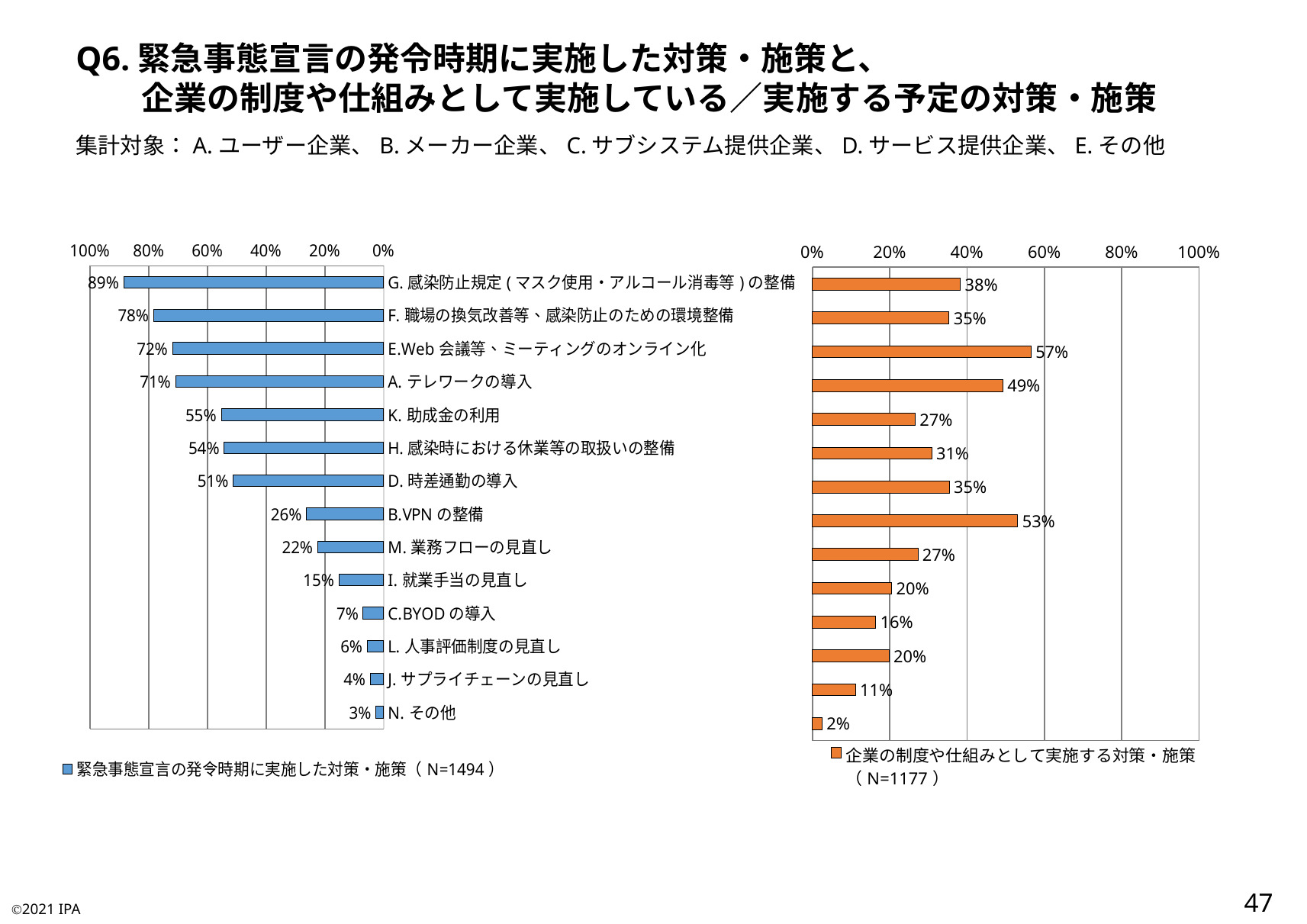
左側のグラフ（緊急事態宣言の発令時期に実施した対策・施策）で、最も値が高い項目はどれですか？ G. 感染防止規定 ( マスク使用・アルコール消毒等 ) の整備 右側のグラフ（企業の制度や仕組みとして実施する対策・施策）で、最も値が高い項目はどれですか？ E.Web 会議等、ミーティングのオンライン化 右側のグラフ（企業の制度や仕組みとして実施する対策・施策）で、「B.VPN の整備」の値はいくつですか？ 53% このスライドのグラフはどの種類のグラフですか？ 棒グラフ 右側のグラフの棒は何色ですか？ オレンジ色 「B.VPN の整備」の値は、左側のグラフ（発令時期に実施）と右側のグラフ（制度として実施）のどちらが大きいですか？ 右側のグラフ（企業の制度や仕組みとして実施する対策・施策） 右側のグラフ（企業の制度や仕組みとして実施する対策・施策）で、最も値が低い項目はどれですか？ N. その他 左側のグラフ（緊急事態宣言の発令時期に実施した対策・施策）で、「A. テレワークの導入」の値はいくつですか？ 71% 左側のグラフ（緊急事態宣言の発令時期に実施した対策・施策）で、「K. 助成金の利用」の値は50%より大きいですか、小さいですか？ 大きい 「E.Web 会議等、ミーティングのオンライン化」について、左側のグラフの値と右側のグラフの値の差はいくつですか？ 15% 左側のグラフの凡例に示されている N の値はいくつですか？ N=1494 左側のグラフには項目がいくつありますか？ 14